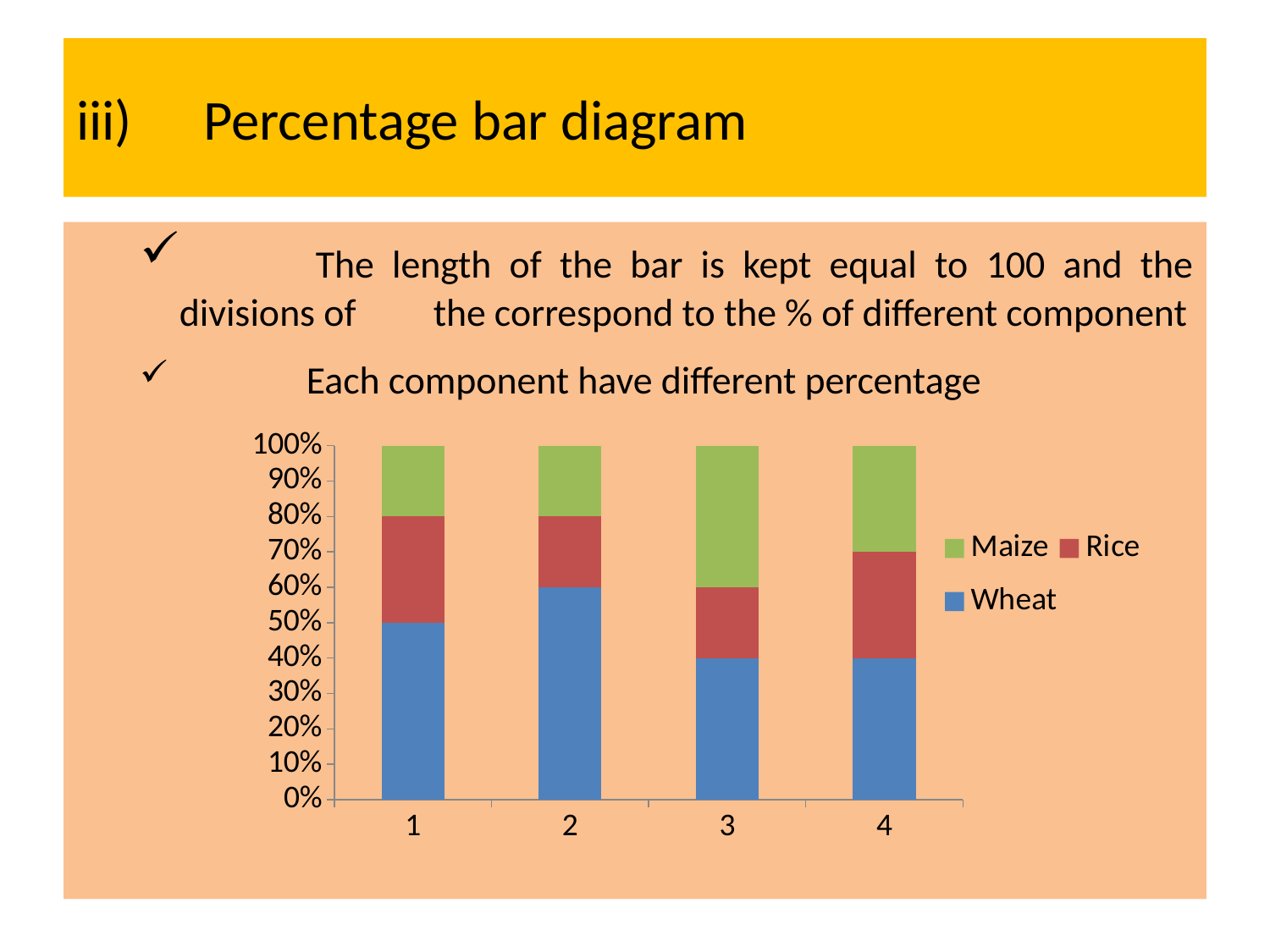
How many bars (categories) are plotted on the x axis? 4 What is the Wheat value for category 2? 60% Which is larger, the Wheat value for category 2 or the Wheat value for category 3? Category 2 What is the Wheat value for category 3? 40% Which category has the largest Maize segment? 3 What is the Wheat value for category 1? 50% What is the total height of each stacked bar? 100% Is the Rice value for category 2 greater or less than 30%? less What kind of chart is shown on the slide? Stacked bar chart Is the Maize value for category 3 greater or less than 30%? greater Which category has the highest Wheat value? 2 How many series does the legend list? 3